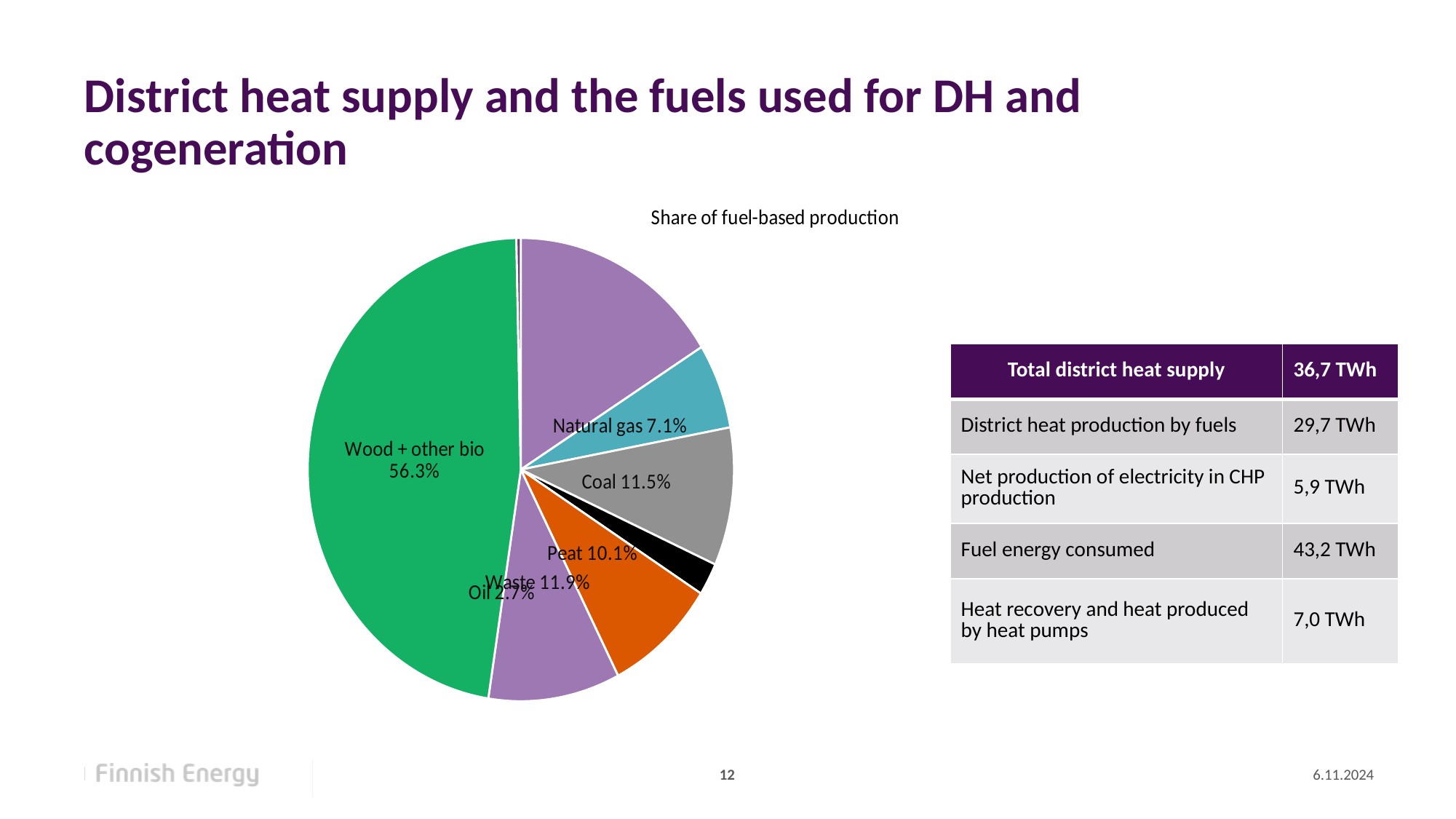
What kind of chart is shown on the slide? pie chart What share does Natural gas have in the pie chart? 7.1% Which has a larger share, Coal or Natural gas? Coal What is the difference between the shares of Waste and Peat? 1.8% What share does Oil have in the pie chart? 2.7% What share does Coal have in the pie chart? 11.5% Which labelled fuel has the smallest share of fuel-based production? Oil What share does Wood + other bio have in the pie chart? 56.3% What is the difference between the shares of Coal and Natural gas? 4.4% What is the title of the chart? Share of fuel-based production Which labelled fuel has the largest share of fuel-based production? Wood + other bio What share does Peat have in the pie chart? 10.1%